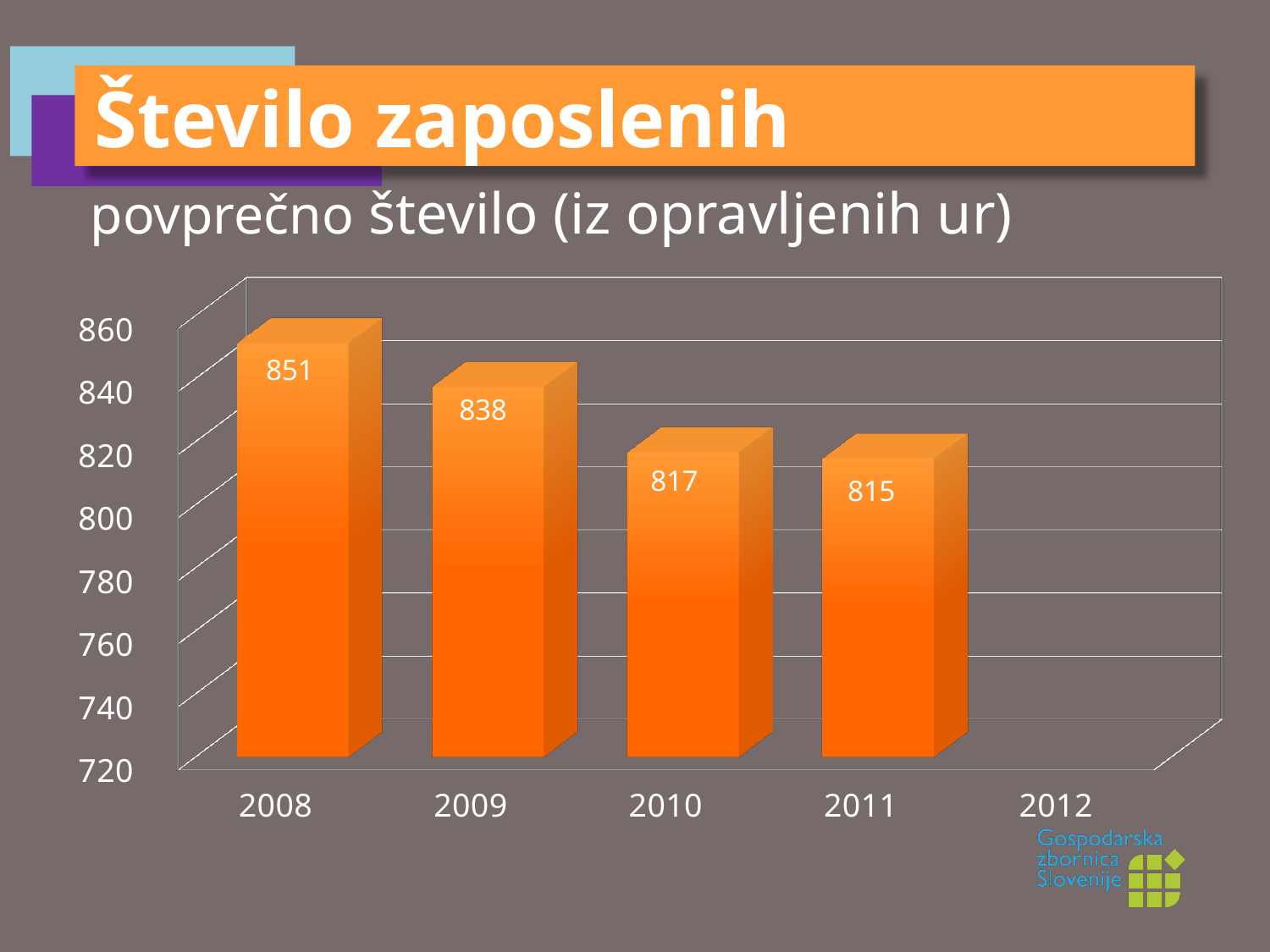
Which is larger, the value for 2009 or the value for 2010? 2009 What is the value for 2009? 838 What is the difference between the values for 2008 and 2009? 13 Which year has the highest value? 2008 What is the value for 2008? 851 How many bars are plotted in the chart? 4 What is the value for 2010? 817 What is the value for 2011? 815 What is the difference between the values for 2008 and 2011? 36 Is the value for 2010 greater or less than 800? greater Do the values rise or fall from 2008 to 2011? fall Which year has the lowest value among the plotted bars? 2011